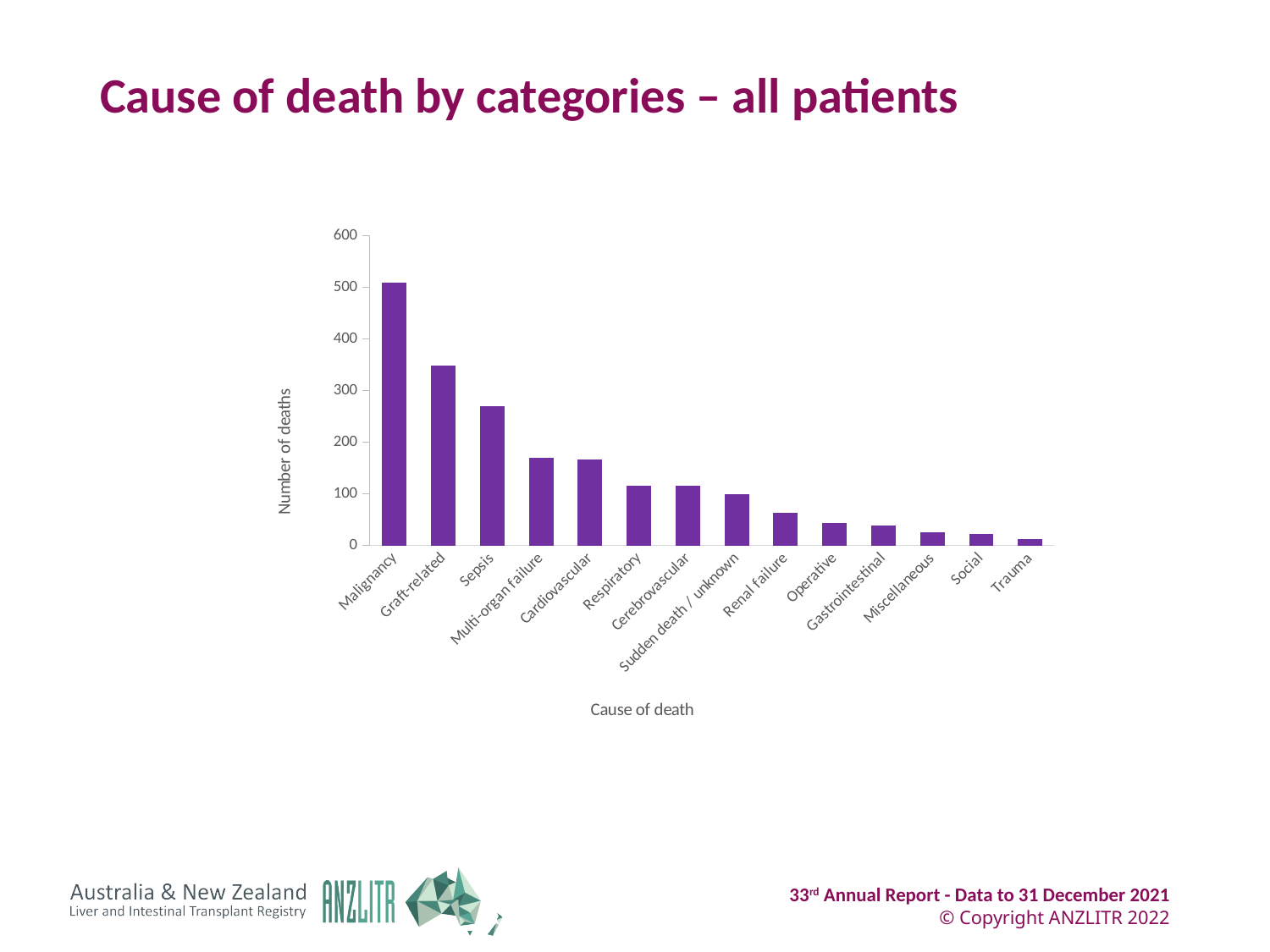
Is the value for Malignancy greater or less than 500? greater Which has more deaths, Sepsis or Renal failure? Sepsis Is the value for Graft-related greater or less than 400? less What is the label of the y axis? Number of deaths Is the value for Sepsis greater or less than 200? greater Which has more deaths, Respiratory or Operative? Respiratory What kind of chart is shown on the slide? bar chart Do the values rise or fall moving from left to right along the x axis? fall Which cause of death has the highest number of deaths? Malignancy Which cause of death has the lowest number of deaths? Trauma How many cause-of-death categories are shown on the x axis? 14